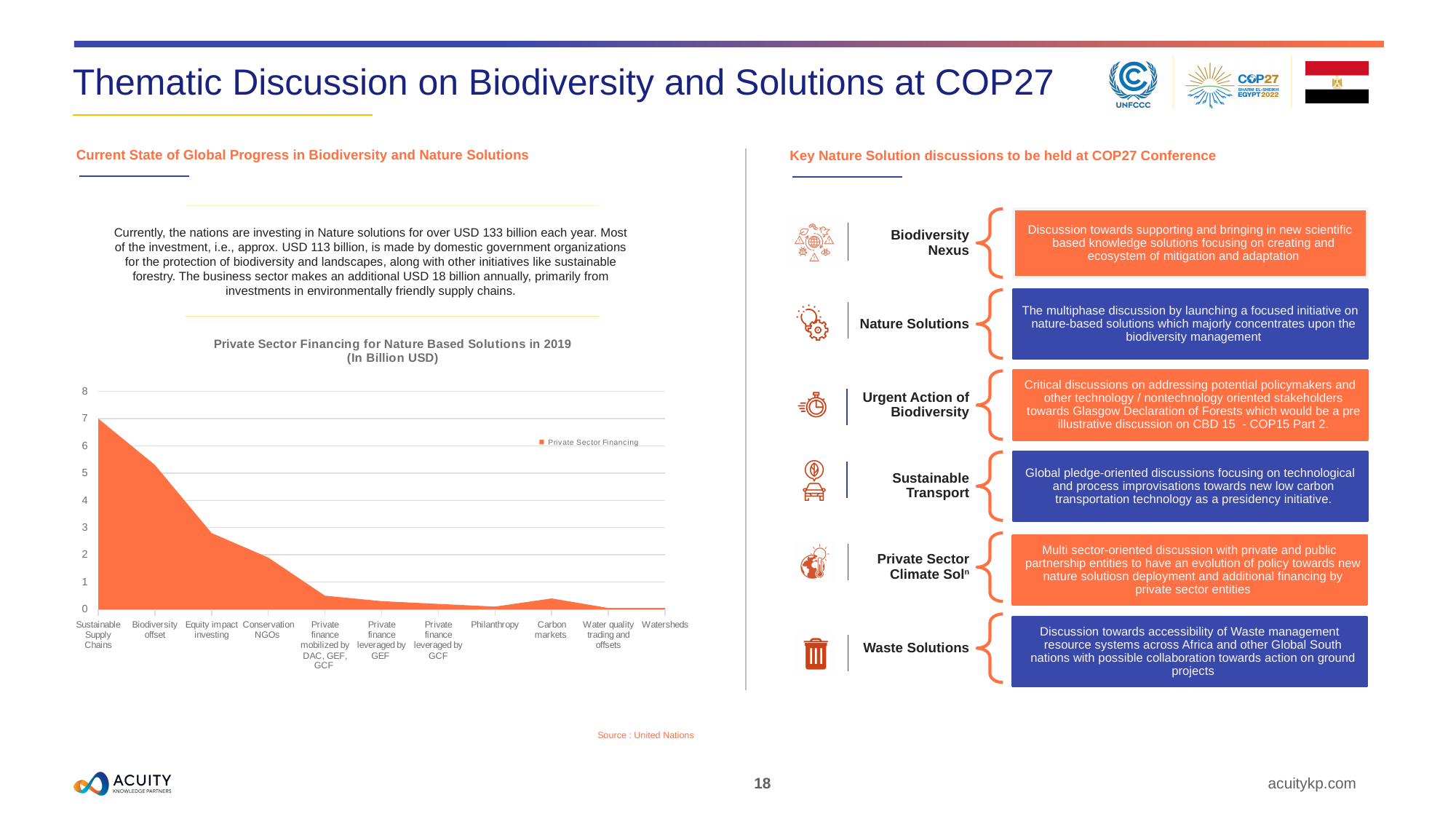
In the Private Sector Financing for Nature Based Solutions in 2019 chart, is the value for Sustainable Supply Chains greater or less than 6? greater Which category has the highest value in the Private Sector Financing for Nature Based Solutions in 2019 chart? Sustainable Supply Chains In the Private Sector Financing for Nature Based Solutions in 2019 chart, is the value for Biodiversity offset greater or less than 3? greater In the Private Sector Financing for Nature Based Solutions in 2019 chart, do the values generally rise or fall from left to right along the x axis? Fall How many categories are shown on the x axis of the Private Sector Financing for Nature Based Solutions in 2019 chart? 11 In the Private Sector Financing for Nature Based Solutions in 2019 chart, is the value for Conservation NGOs greater or less than 3? less What kind of chart is shown under the title "Private Sector Financing for Nature Based Solutions in 2019"? Area chart In the Private Sector Financing for Nature Based Solutions in 2019 chart, which is larger: Sustainable Supply Chains or Biodiversity offset? Sustainable Supply Chains How many series does the legend of the Private Sector Financing for Nature Based Solutions in 2019 chart list? 1 What unit is stated in the title of the Private Sector Financing for Nature Based Solutions in 2019 chart? In Billion USD What is the legend entry shown in the Private Sector Financing for Nature Based Solutions in 2019 chart? Private Sector Financing